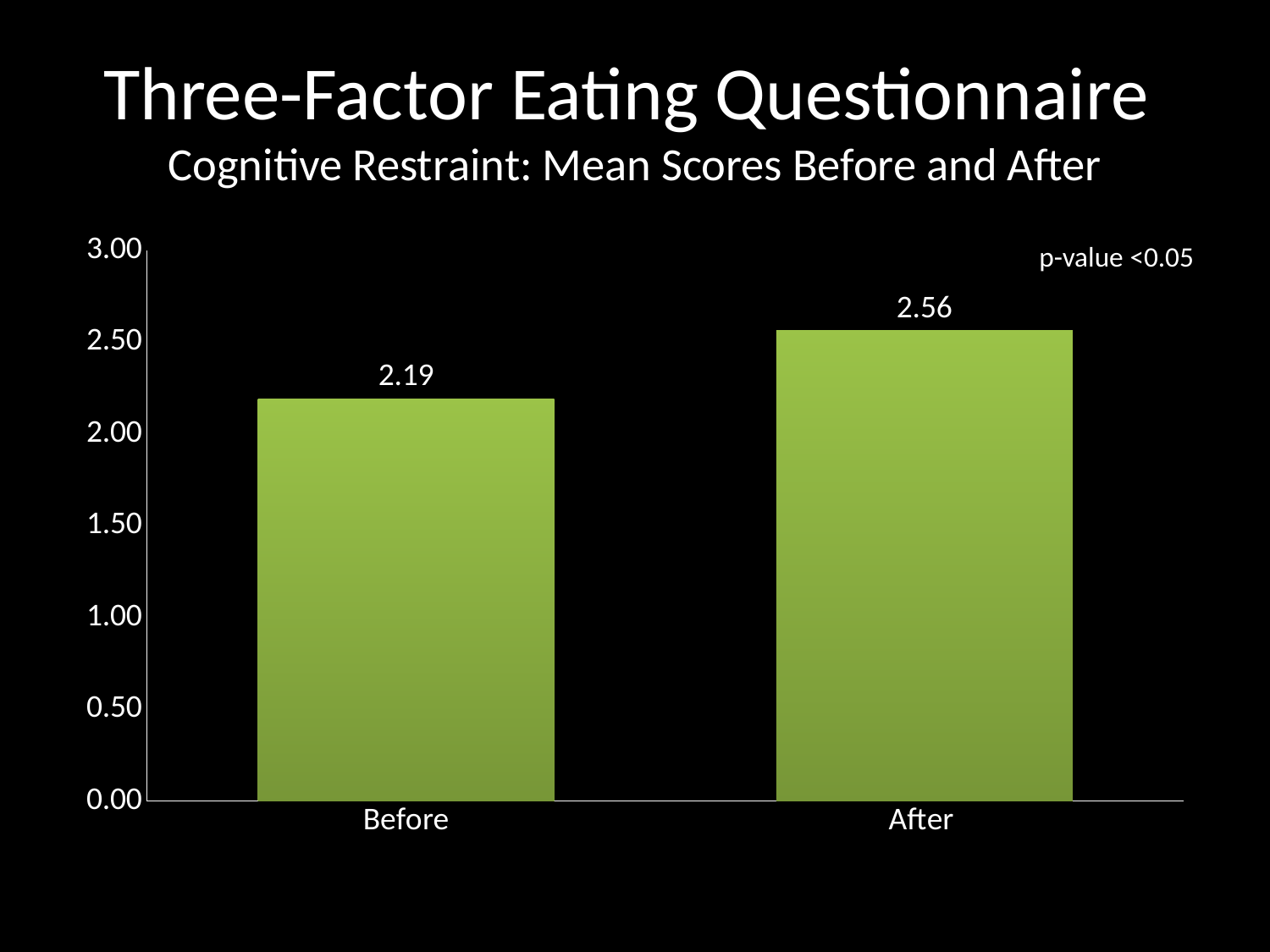
What kind of chart is shown on the slide? bar chart Is the value for Before greater or less than 2.50? less Which category has the lower mean score? Before How many categories are shown on the x axis? 2 What is the mean cognitive restraint score for Before? 2.19 What is the mean cognitive restraint score for After? 2.56 Which category has the higher mean score, Before or After? After Is the value for After greater or less than 2.50? greater What is the maximum value shown on the y axis? 3.00 What is the difference between the After and Before mean scores? 0.37 Do the mean scores rise or fall from Before to After? rise What p-value is noted on the chart? p-value <0.05